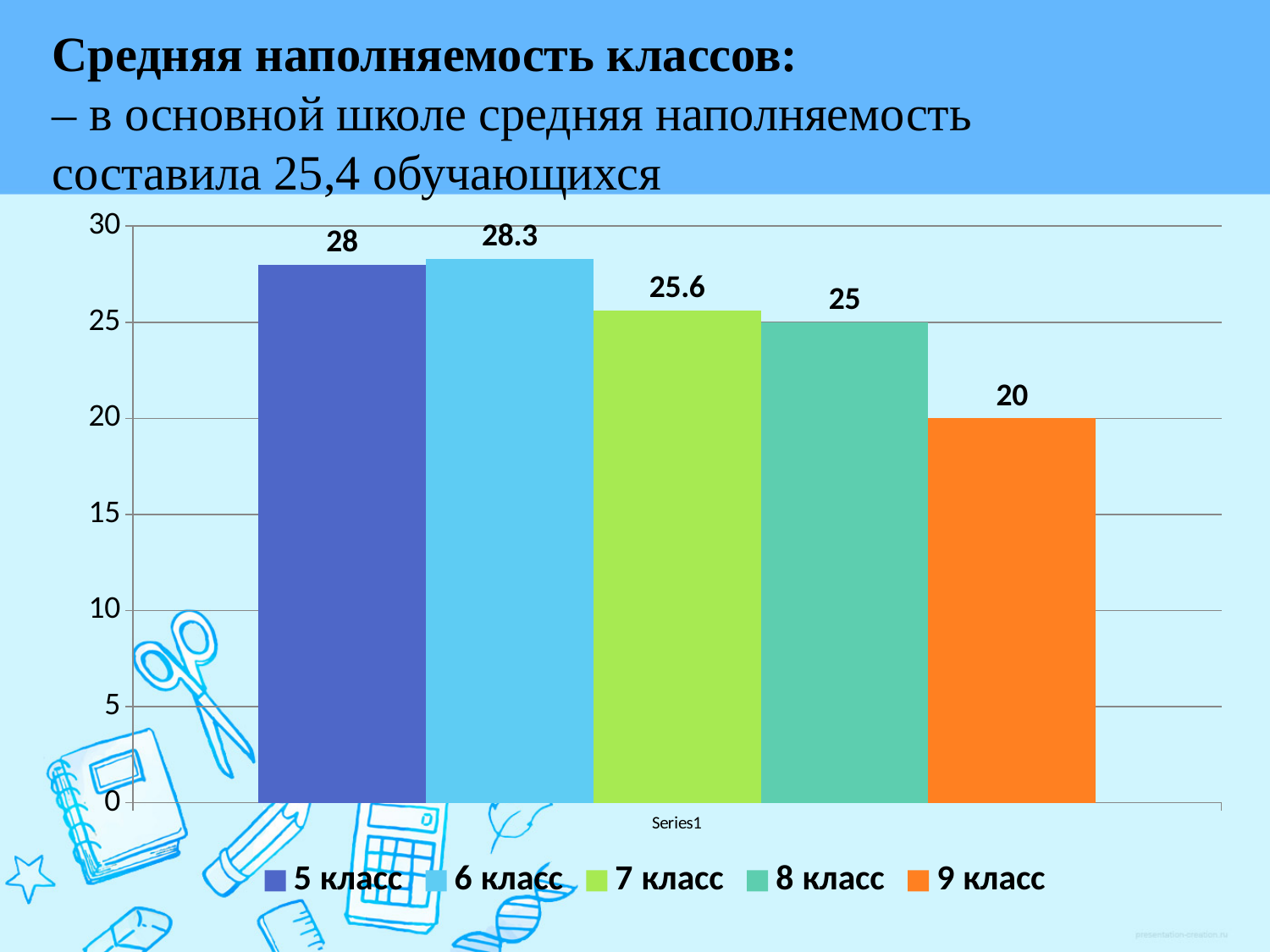
How many classes are shown in the chart? 5 What is the difference between the values for 5 класс and 9 класс? 8 How many entries does the legend list? 5 What is the difference between the values for 6 класс and 8 класс? 3.3 What kind of chart is shown on the slide? bar chart What is the value for 9 класс? 20 What is the value for 7 класс? 25.6 What colour is the bar for 9 класс? orange Which class has the lowest value? 9 класс What is the value for 6 класс? 28.3 Which class has the highest value? 6 класс Which is larger, the value for 7 класс or the value for 8 класс? 7 класс